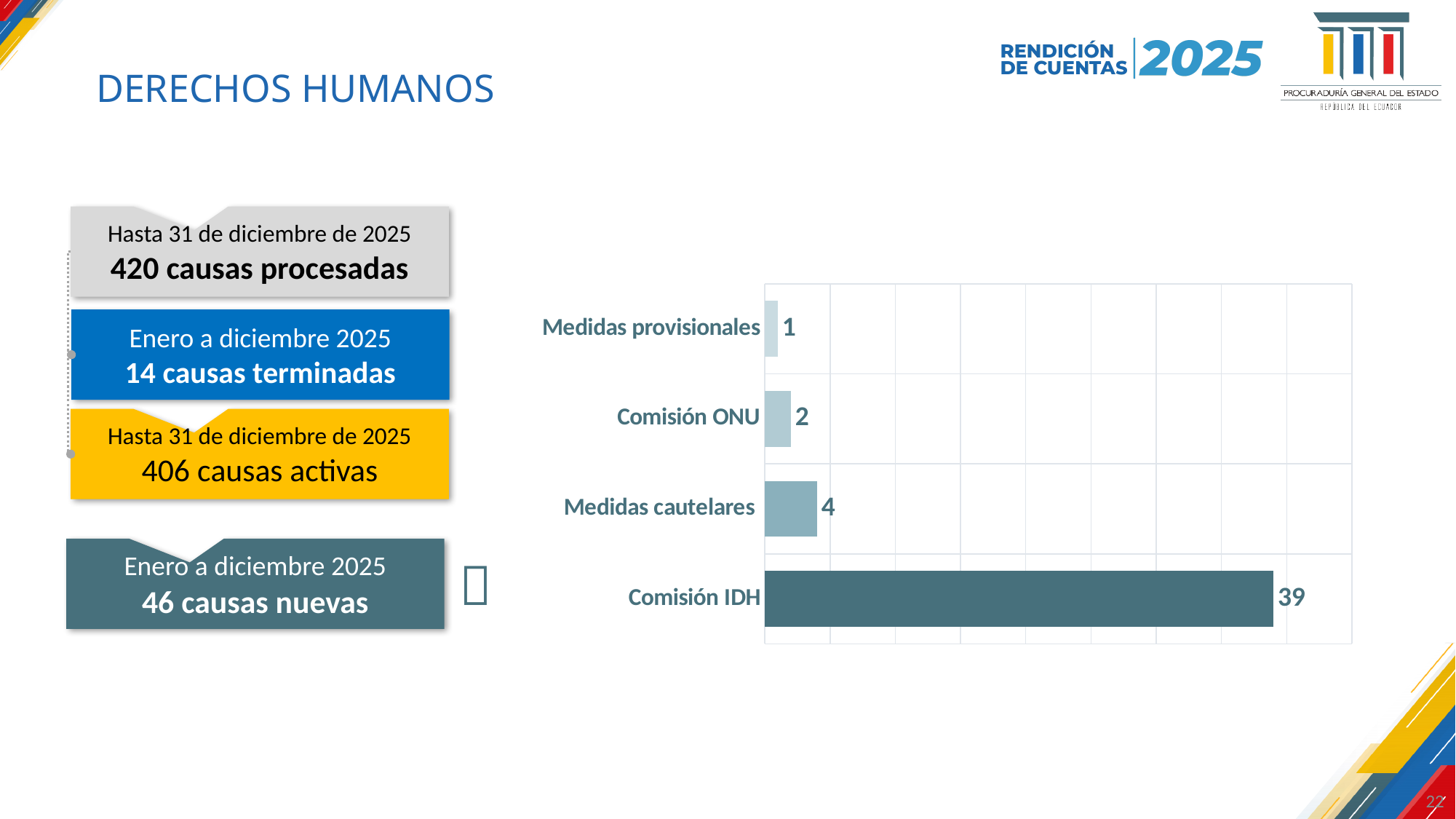
What kind of chart is shown on the slide? bar chart Which category has the highest value? Comisión IDH What is the value for Medidas provisionales? 1 What is the difference between the values for Comisión IDH and Medidas cautelares? 35 Which is larger, the value for Comisión ONU or the value for Medidas cautelares? Medidas cautelares What is the difference between the values for Medidas cautelares and Comisión ONU? 2 Which category has the lowest value? Medidas provisionales What is the value for Comisión IDH? 39 How many categories are shown in the chart? 4 What is the total of all four values in the chart? 46 What is the value for Comisión ONU? 2 What is the value for Medidas cautelares? 4